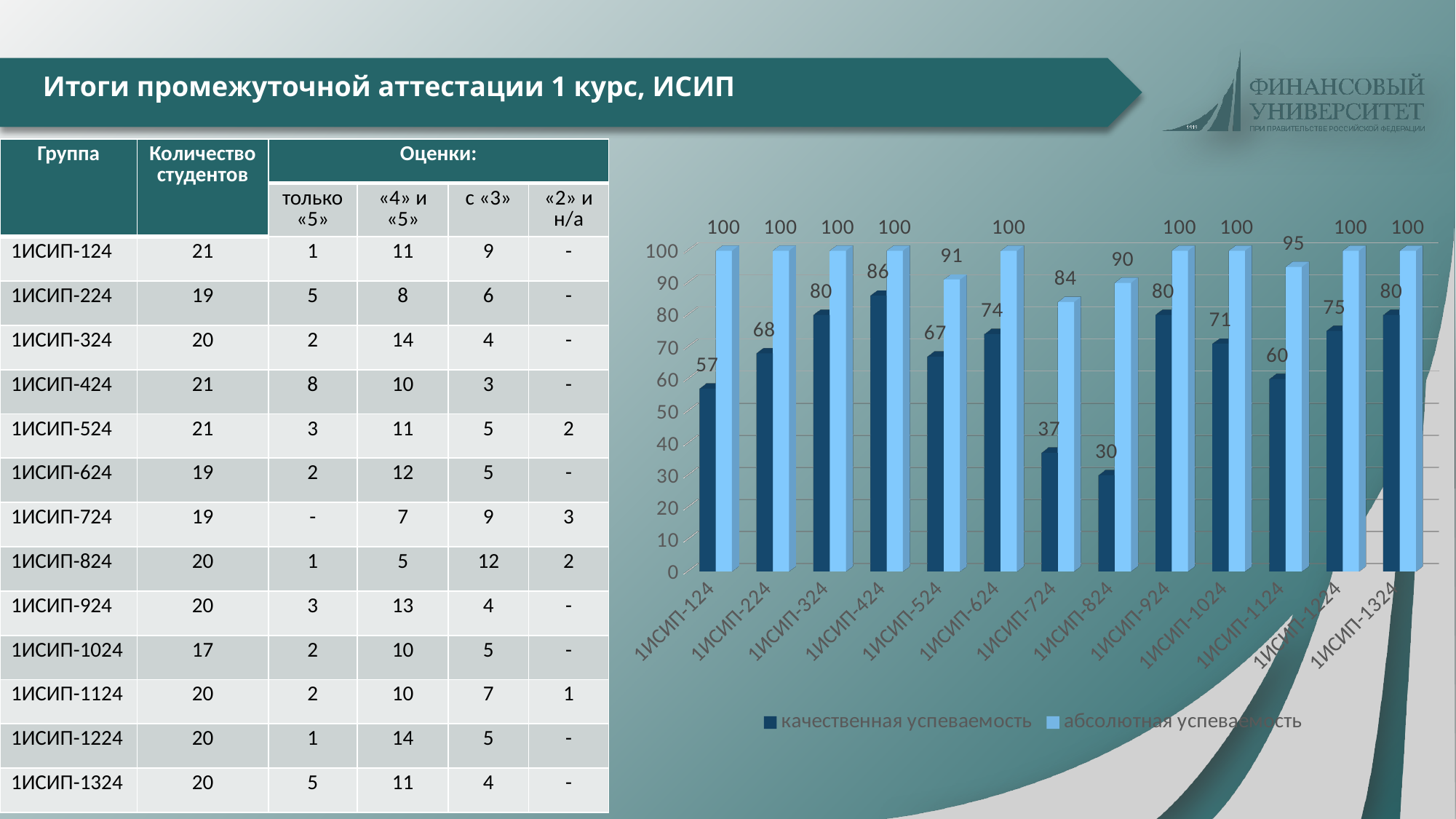
What is the абсолютная успеваемость value for 1ИСИП-724 in the chart? 84 Which series in the chart is shown in dark blue? качественная успеваемость How many series does the chart legend list? 2 How many groups are shown on the x axis of the chart? 13 What is the качественная успеваемость value for 1ИСИП-424 in the chart? 86 Which is larger in the chart: качественная успеваемость for 1ИСИП-224 or for 1ИСИП-1124? 1ИСИП-224 What is the difference between абсолютная успеваемость and качественная успеваемость for 1ИСИП-524 in the chart? 24 Which group has the highest качественная успеваемость in the chart? 1ИСИП-424 Which group has the lowest качественная успеваемость in the chart? 1ИСИП-824 Which group has the lowest абсолютная успеваемость in the chart? 1ИСИП-724 What type of chart is shown on the slide? Bar chart What is the абсолютная успеваемость value for 1ИСИП-1124 in the chart? 95